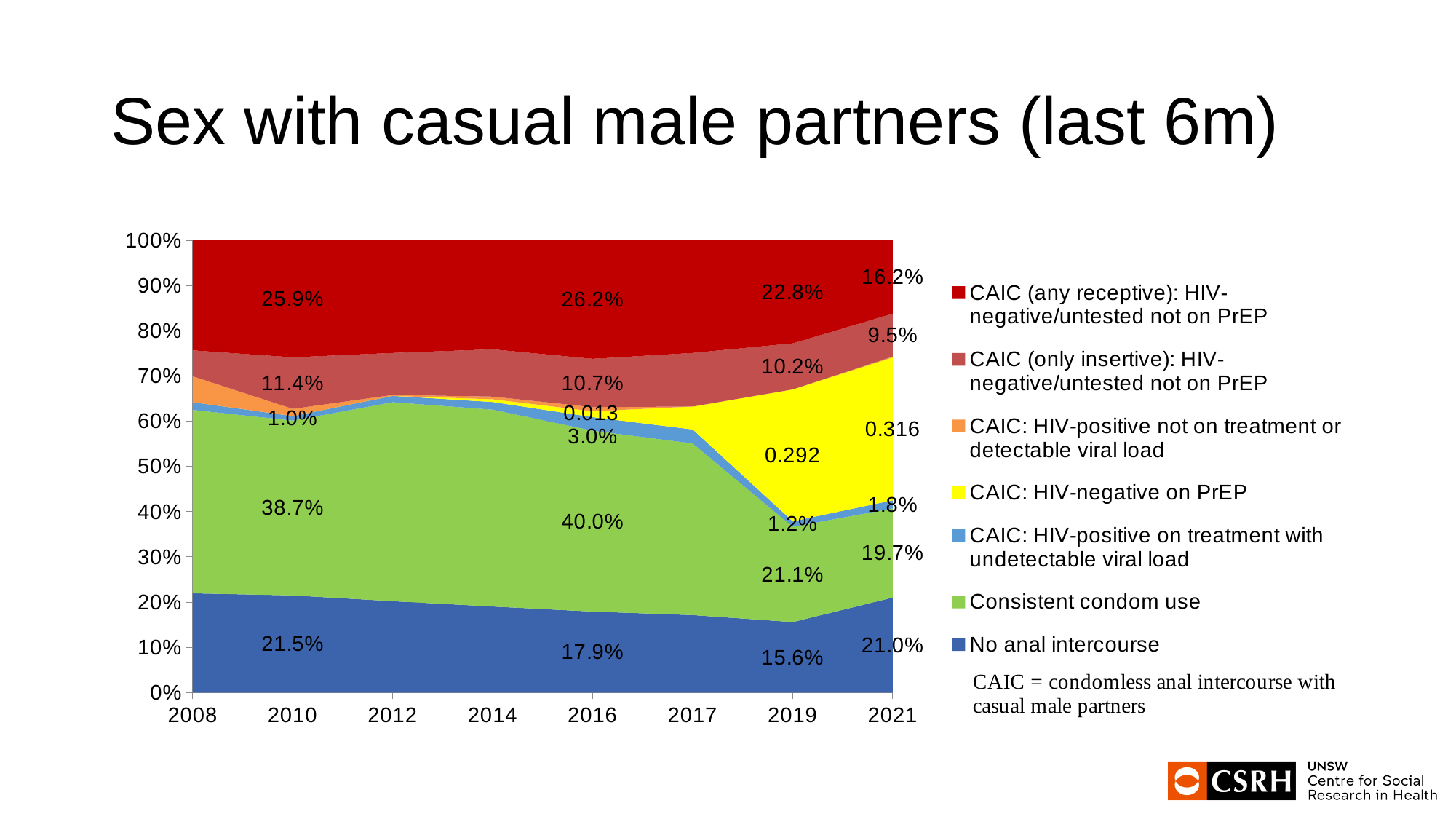
What is the difference between the 'Consistent condom use' values in 2016 and 2019? 18.9% What kind of chart is shown on the slide? stacked area chart What is the value for 'No anal intercourse' in 2019? 15.6% What is the value for 'CAIC (only insertive): HIV-negative/untested not on PrEP' in 2016? 10.7% What is the value for 'CAIC: HIV-negative on PrEP' in 2019? 0.292 How many years are shown on the x axis? 8 Which is larger in 2021: 'No anal intercourse' or 'Consistent condom use'? No anal intercourse Does the 'CAIC (any receptive): HIV-negative/untested not on PrEP' value rise or fall from 2016 to 2021? fall What is the title of the chart? Sex with casual male partners (last 6m) What is the value for 'Consistent condom use' in 2010? 38.7% How many series does the legend list? 7 What is the value for 'CAIC (any receptive): HIV-negative/untested not on PrEP' in 2021? 16.2%